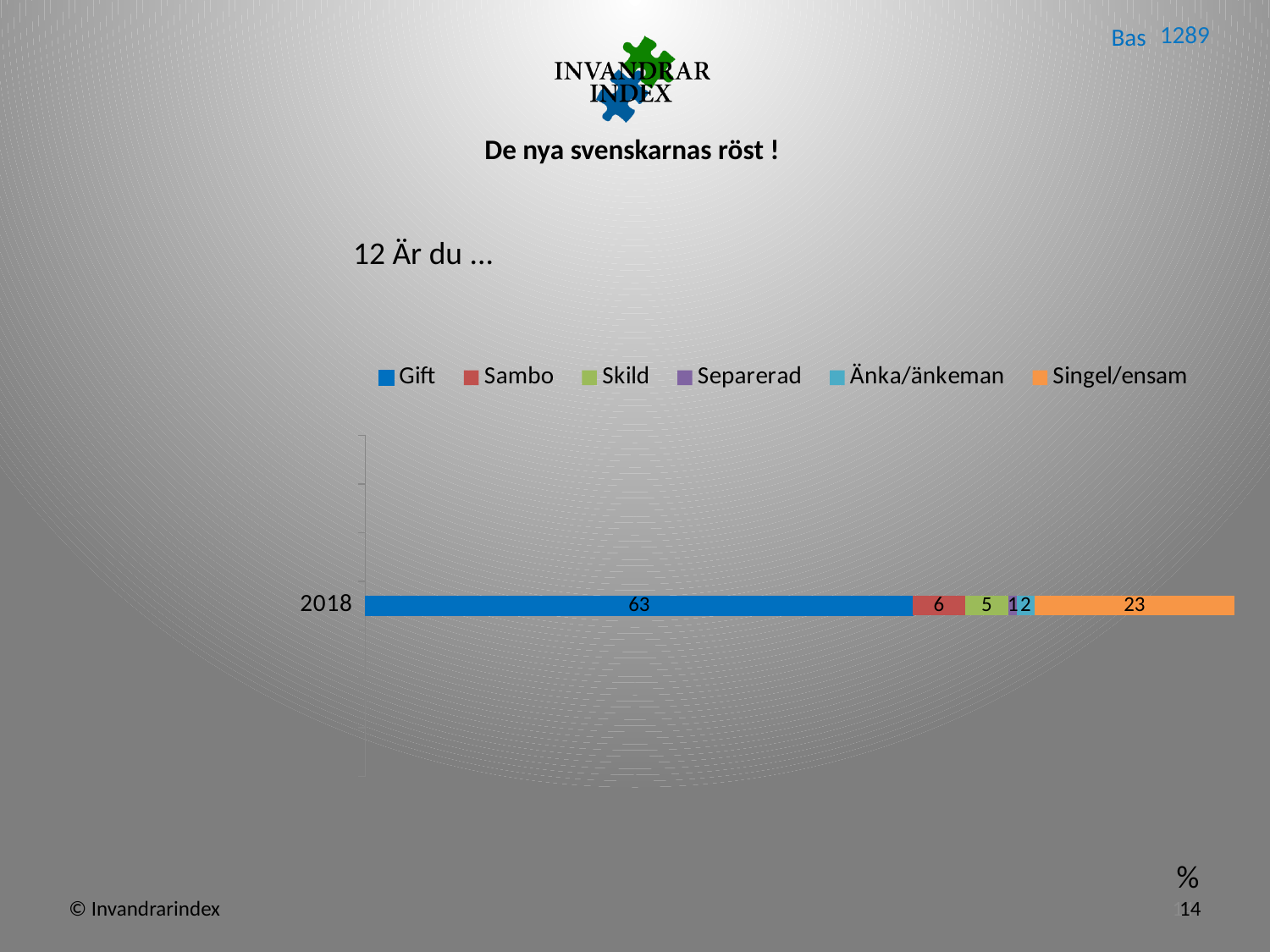
Which is larger in 2018, Sambo or Skild? Sambo What is the value for Skild in 2018? 5 Which series has the highest value in 2018? Gift What is the total of the stacked bar for 2018? 100 Which series has the lowest value in 2018? Separerad What is the value for Sambo in 2018? 6 How many series does the legend list? 6 What is the difference between the values for Gift and Singel/ensam in 2018? 40 What kind of chart is shown on the slide? Stacked bar chart What is the value for Gift in 2018? 63 What is the title of the chart? 12 Är du ... What is the value for Singel/ensam in 2018? 23